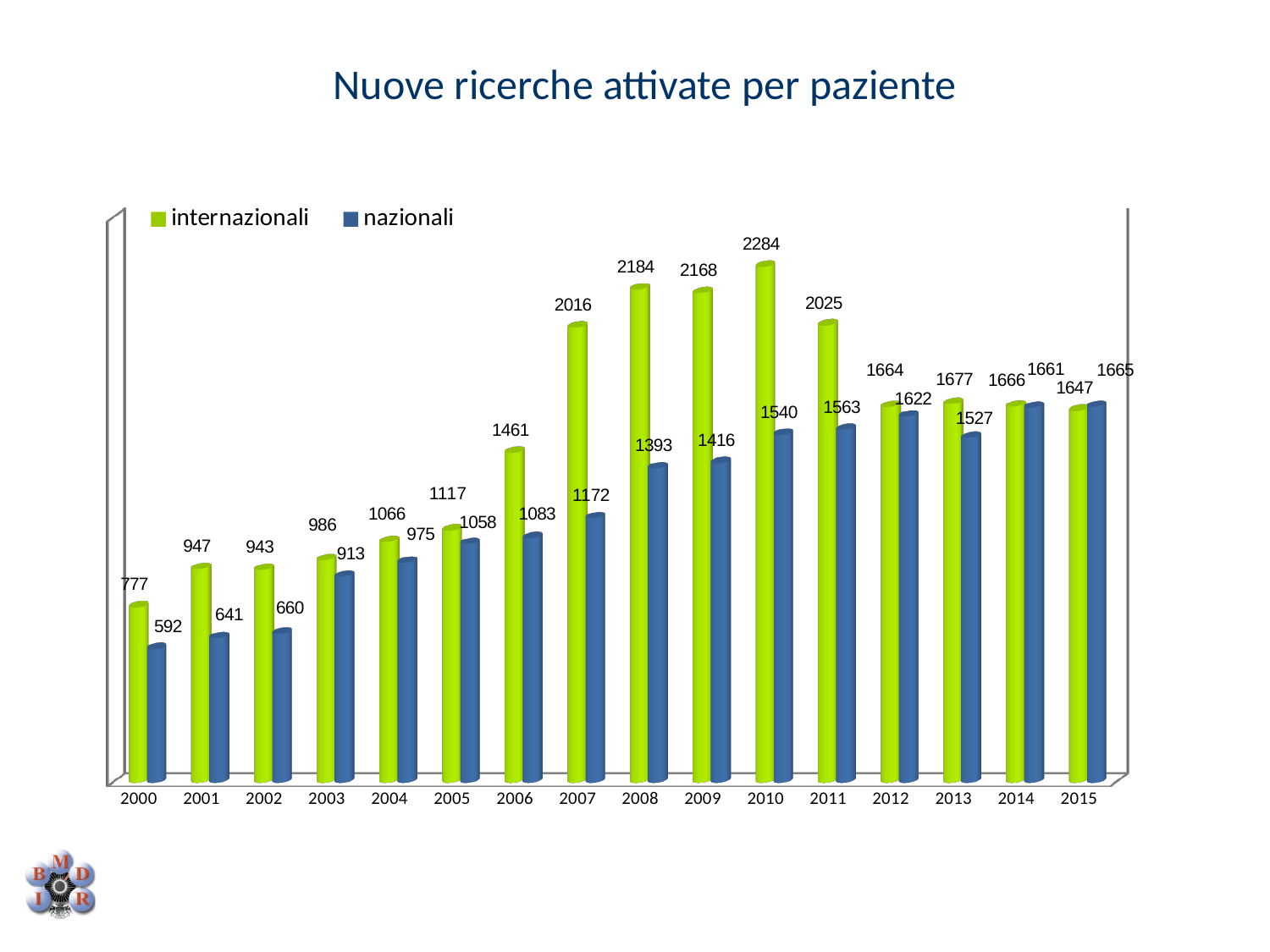
What is the difference between internazionali and nazionali in 2000? 185 How many years are shown on the x axis? 16 How many series does the legend list? 2 What is the difference between internazionali and nazionali in 2010? 744 In which year is the internazionali value highest? 2010 In which year is the nazionali value lowest? 2000 What is the value for internazionali in 2010? 2284 What is the value for nazionali in 2008? 1393 What is the value for internazionali in 2000? 777 Which is larger in 2007, internazionali or nazionali? internazionali What is the title of the chart? Nuove ricerche attivate per paziente What kind of chart is shown on the slide? bar chart